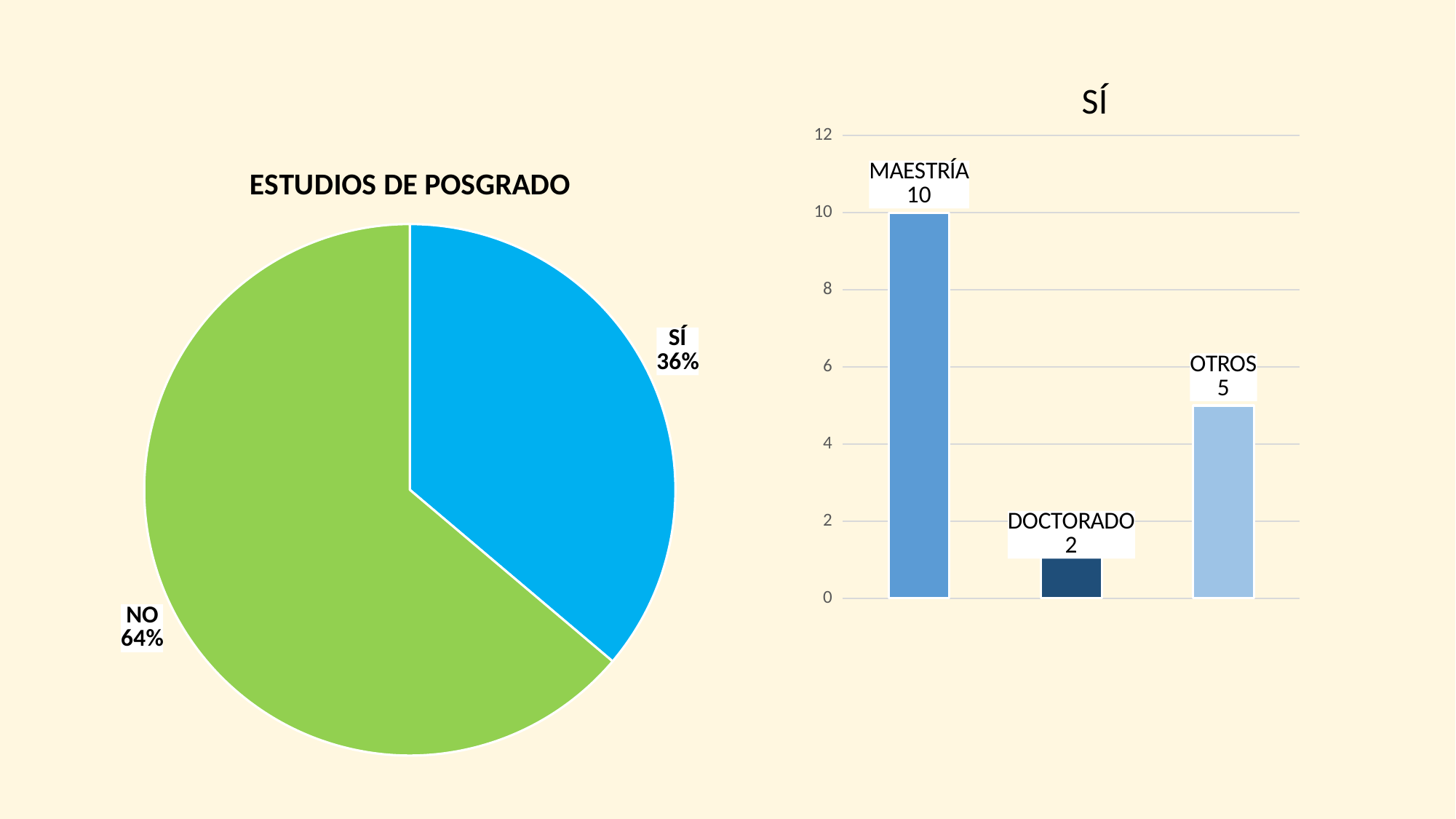
In the 'SÍ' chart, what is the value for DOCTORADO? 2 In the 'ESTUDIOS DE POSGRADO' pie chart, how many slices are there? 2 In the 'ESTUDIOS DE POSGRADO' pie chart, what is the difference in percentage points between NO and SÍ? 28 What kind of chart is the 'ESTUDIOS DE POSGRADO' chart? Pie chart What kind of chart is the 'SÍ' chart? Bar chart In the 'SÍ' chart, what is the value for MAESTRÍA? 10 In the 'SÍ' chart, which category has the lowest value? DOCTORADO In the 'ESTUDIOS DE POSGRADO' pie chart, what percentage is shown for SÍ? 36% In the 'ESTUDIOS DE POSGRADO' pie chart, what percentage is shown for NO? 64% In the 'SÍ' chart, what is the value for OTROS? 5 In the 'SÍ' chart, what is the difference between MAESTRÍA and OTROS? 5 In the 'ESTUDIOS DE POSGRADO' pie chart, which slice is the largest? NO